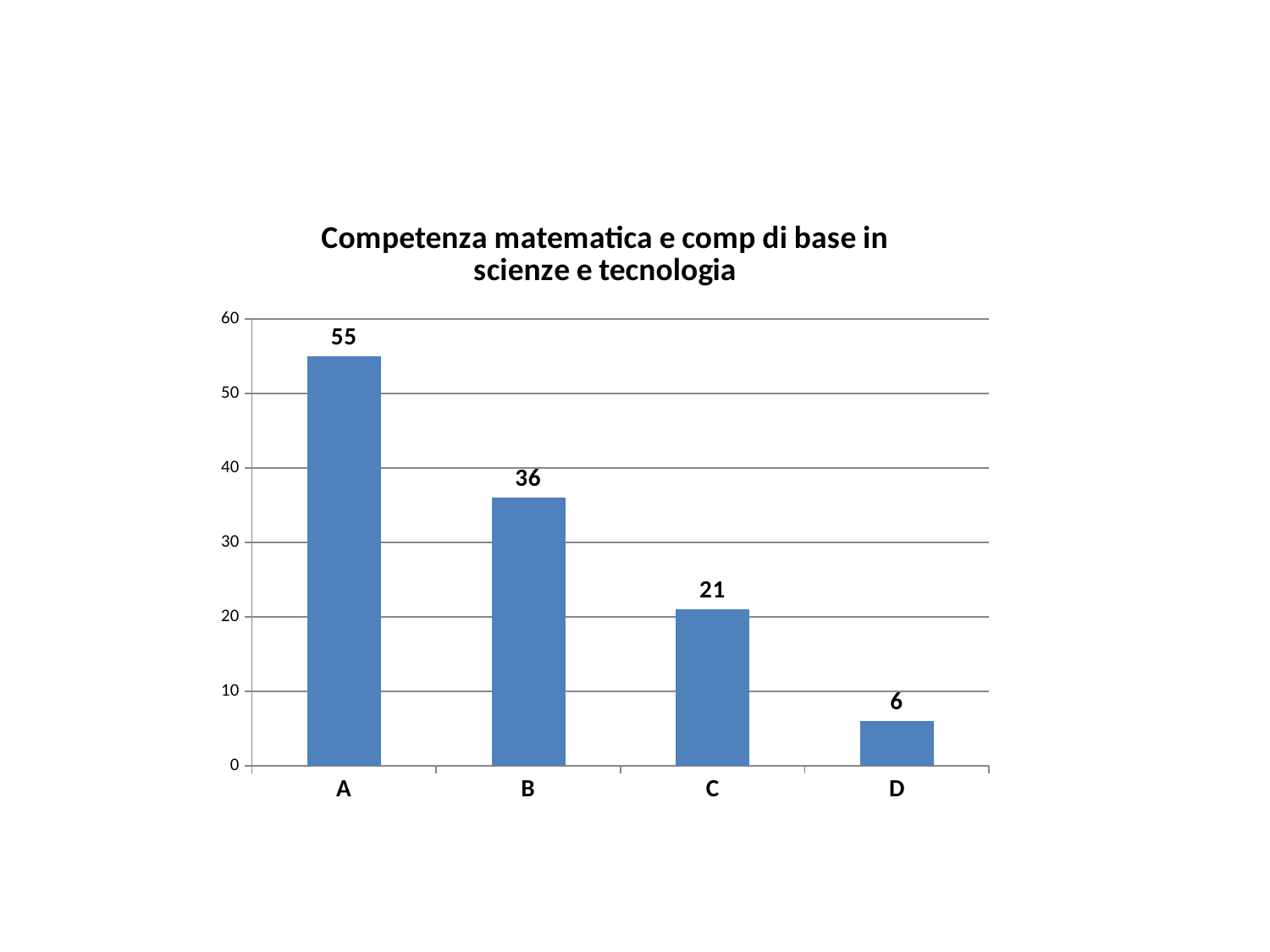
What is the difference between the values for A and B? 19 What kind of chart is shown on the slide? bar chart What is the value for category D? 6 Which category has the lowest value? D How many categories are shown on the x axis? 4 What is the value for category A? 55 What is the value for category C? 21 Is the value for B greater or less than 40? less What is the difference between the values for C and D? 15 Do the values rise or fall from A to D? fall Which is larger, the value for B or the value for C? B Which category has the highest value? A